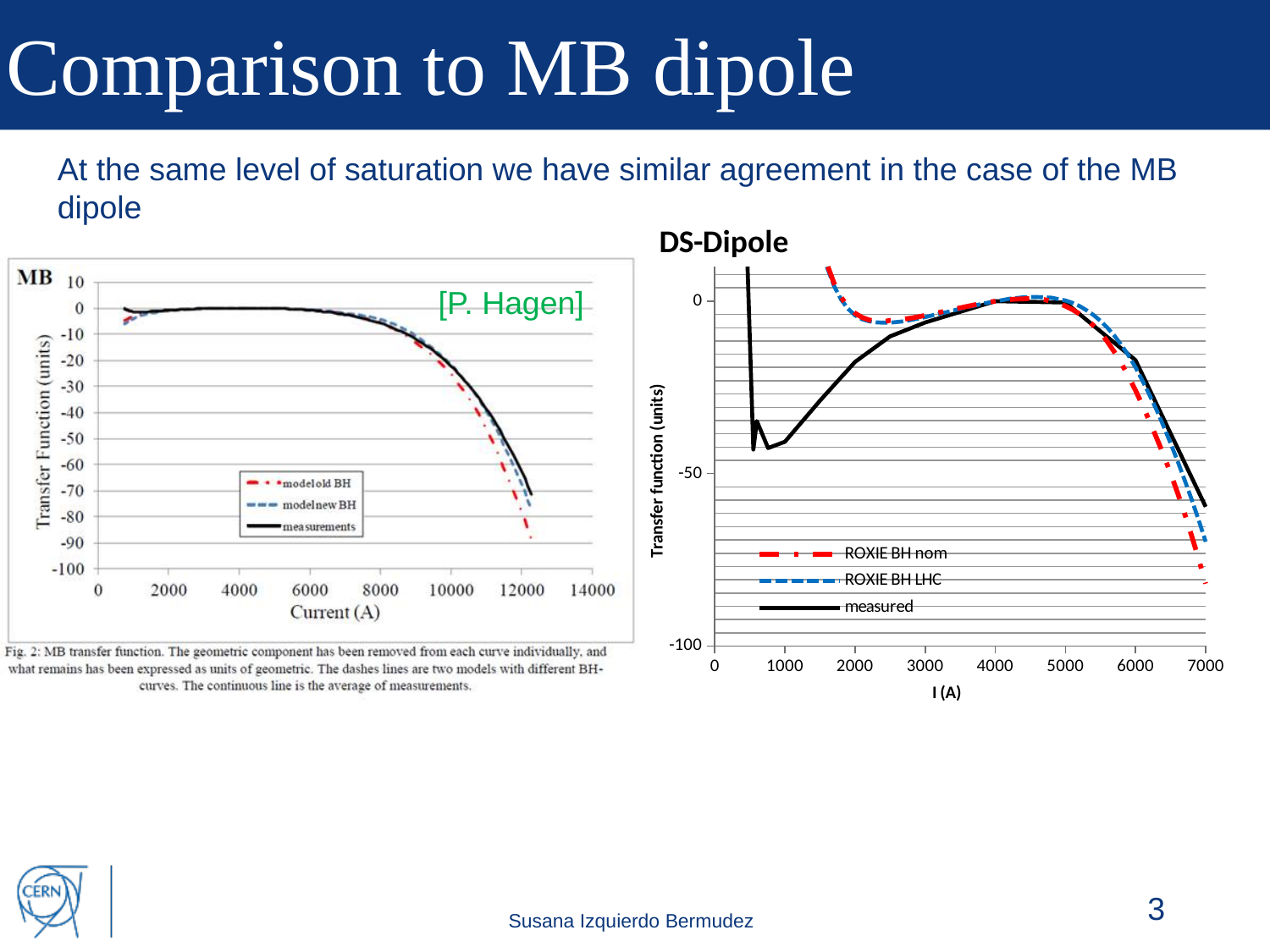
How many series does the legend of the MB chart on the left list? 3 In the DS-Dipole chart, does the measured curve rise or fall between 1000 A and 4000 A? rise In the DS-Dipole chart, is the value of the ROXIE BH nom curve at 7000 A greater or less than -50? less In the DS-Dipole chart, at 7000 A, which curve has the higher value: measured or ROXIE BH nom? measured In the DS-Dipole chart, does the measured curve rise or fall between 5000 A and 7000 A? fall How many series does the legend of the DS-Dipole chart list? 3 What is the x-axis label of the MB chart on the left? Current (A) In the DS-Dipole chart, is the value of the measured curve at 7000 A greater or less than -50? less In the DS-Dipole chart, is the value of the measured curve at 1000 A greater or less than -50? greater What kind of chart is the DS-Dipole chart on the right? line chart